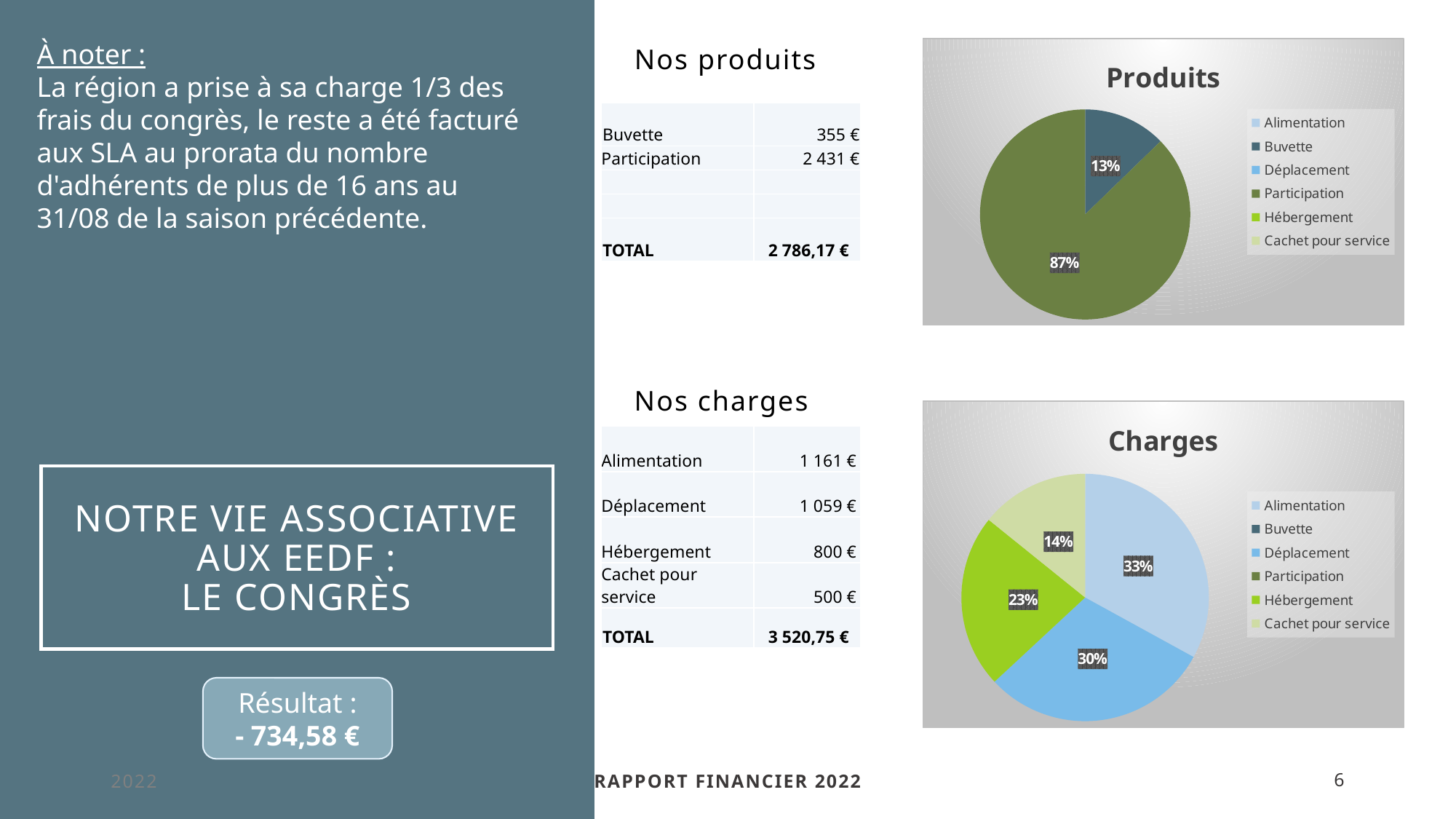
In the Charges chart, which category has the smallest slice? Cachet pour service In the Charges chart, what share of the pie does Hébergement represent? 23% In the Charges chart, how many slices does the pie have? 4 In the Produits chart, what share of the pie does Buvette represent? 13% In the Produits chart, what share of the pie does Participation represent? 87% How many entries does the legend of the Charges chart list? 6 In the Charges chart, what is the difference in percentage points between the Alimentation and Hébergement slices? 10 What kind of chart is the Produits chart? Pie chart In the Produits chart, which category has the largest slice? Participation